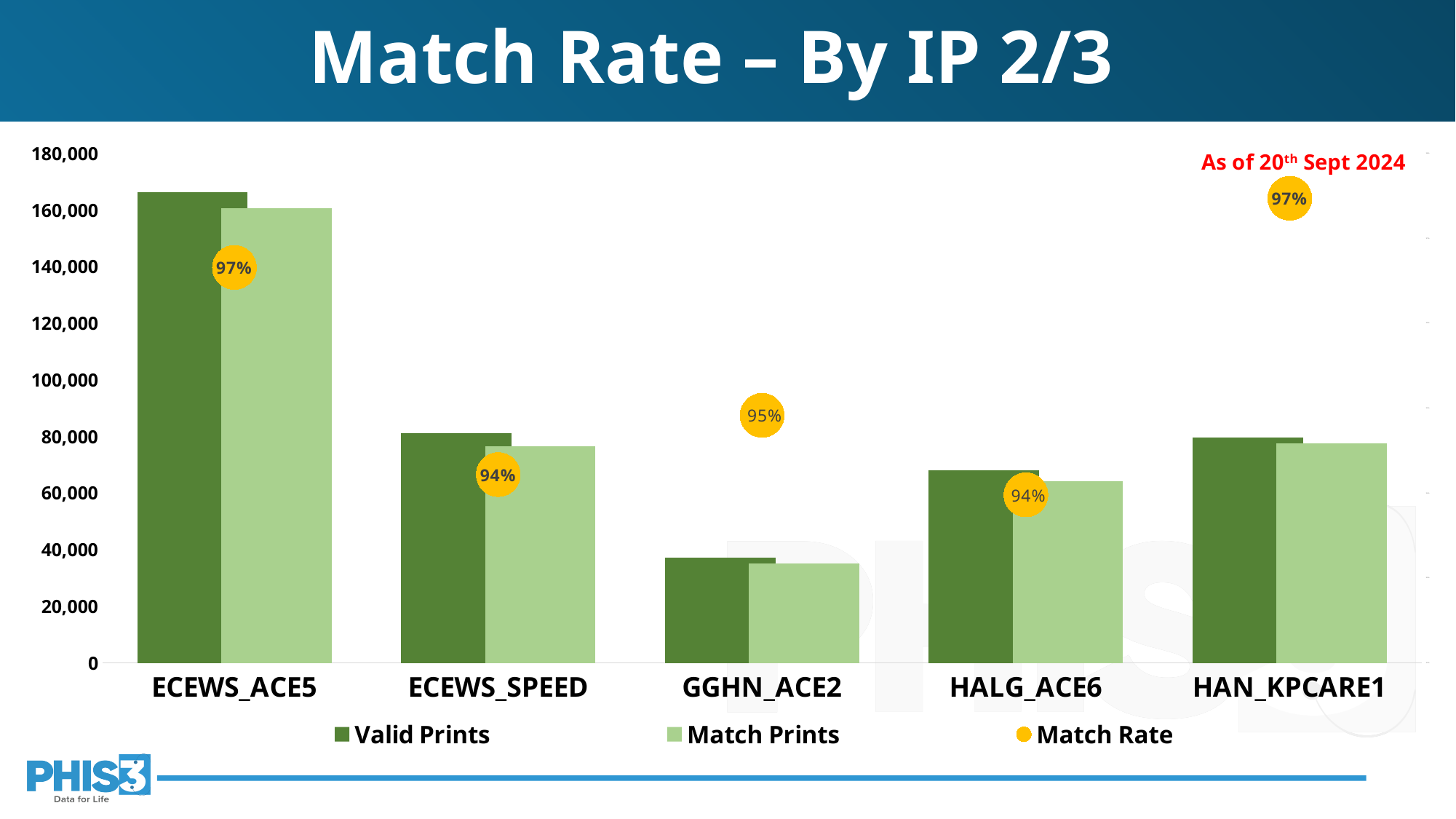
How many IPs are shown on the x axis? 5 Is the Valid Prints value for ECEWS_ACE5 greater or less than 160,000? greater Which has more Valid Prints, ECEWS_SPEED or HALG_ACE6? ECEWS_SPEED Is the Valid Prints value for GGHN_ACE2 greater or less than 40,000? less What is the Match Rate for ECEWS_ACE5? 97% What is the Match Rate for GGHN_ACE2? 95% Which IP has the lowest number of Match Prints? GGHN_ACE2 What is the Match Rate for HALG_ACE6? 94% What is the Match Rate for HAN_KPCARE1? 97% Which IP has the highest number of Valid Prints? ECEWS_ACE5 How many series does the legend list? 3 What type of chart is used to show Valid Prints and Match Prints? Bar chart